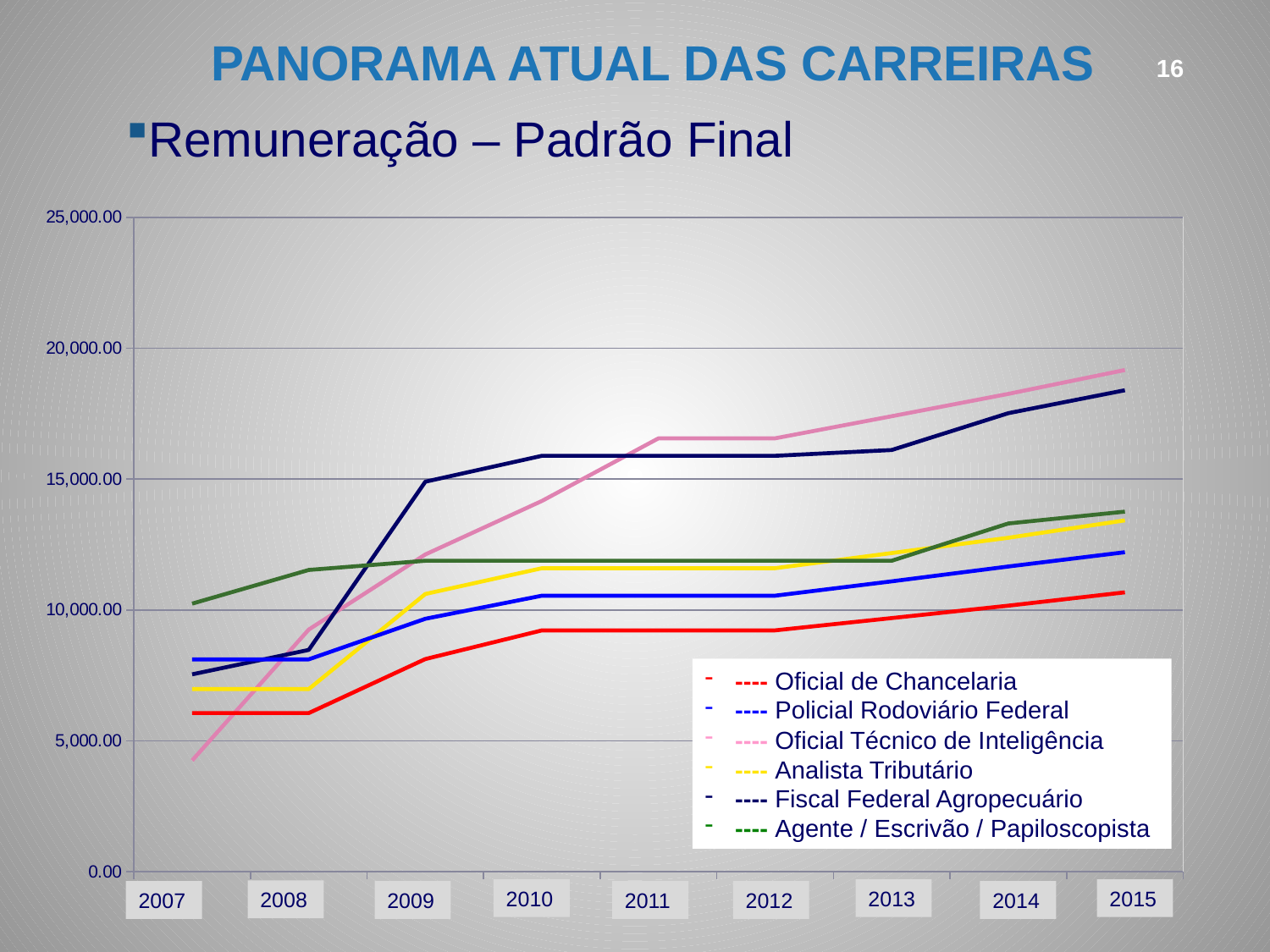
How many series does the legend list? 6 How many years are shown along the x axis? 9 Which series has the lowest value in 2007? Oficial Técnico de Inteligência Which series has the highest value in 2015? Oficial Técnico de Inteligência What colour is the line for Oficial de Chancelaria? Red Which series has the highest value in 2007? Agente / Escrivão / Papiloscopista Is the value for Oficial Técnico de Inteligência in 2007 greater or less than 5,000.00? less In 2009, which is larger: Fiscal Federal Agropecuário or Oficial Técnico de Inteligência? Fiscal Federal Agropecuário Is the value for Oficial de Chancelaria in 2015 greater or less than 10,000.00? greater Does the value for Oficial de Chancelaria rise or fall from 2007 to 2015? Rise What kind of chart is shown on the slide? Line chart Which series has the lowest value in 2015? Oficial de Chancelaria